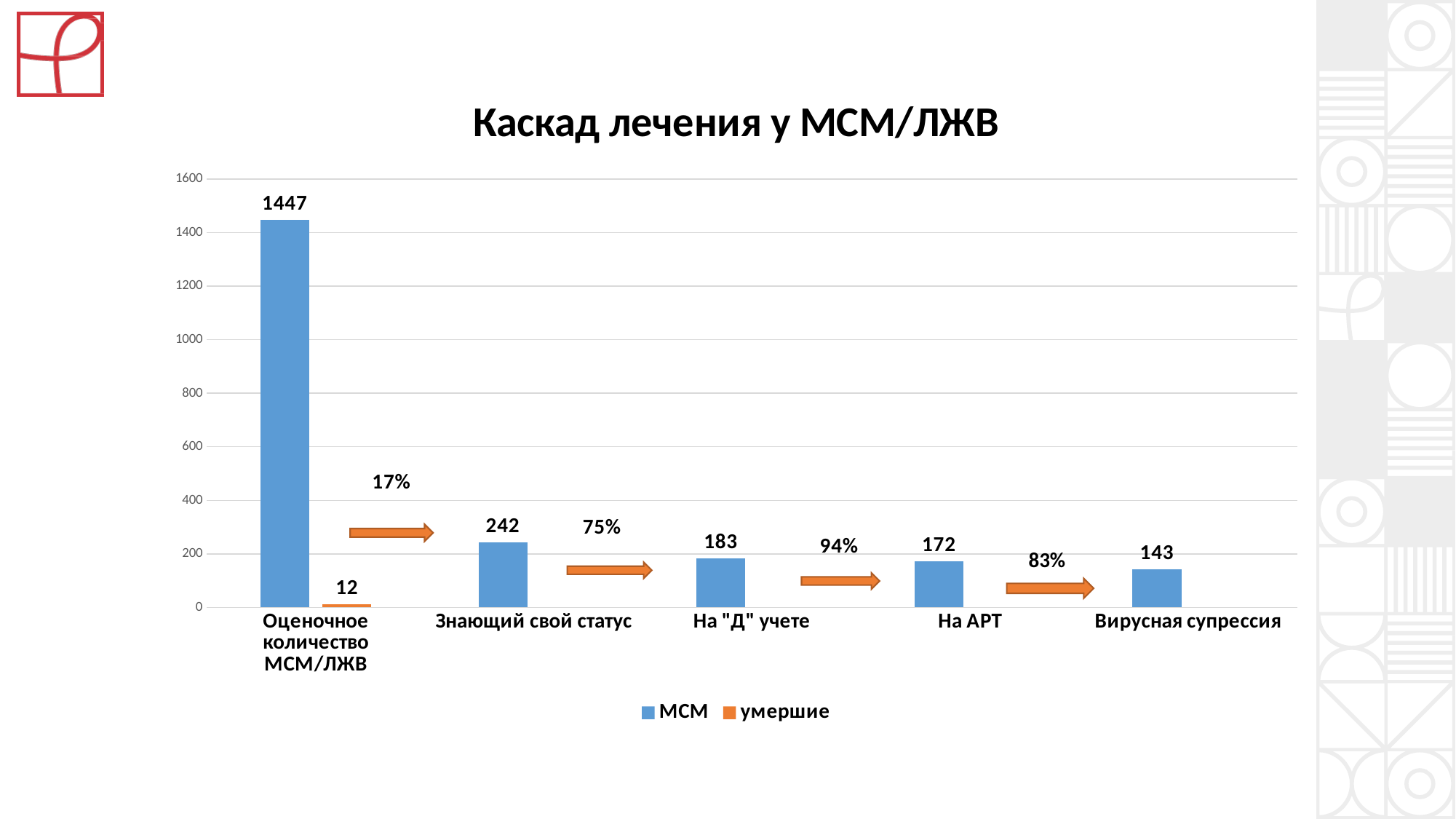
What is the difference between the МСМ values for "Знающий свой статус" and "На "Д" учете"? 59 Which is larger: the МСМ value for "На АРТ" or for "Вирусная супрессия"? На АРТ Which category has the lowest МСМ value? Вирусная супрессия What is the value of the МСМ series for "На АРТ"? 172 How many categories are shown on the x axis? 5 What is the value of the МСМ series for "Оценочное количество МСМ/ЛЖВ"? 1447 Do the МСМ values rise or fall from left to right along the x axis? Fall What kind of chart is shown on the slide? Bar chart How many series does the legend list? 2 What is the value of the МСМ series for "Вирусная супрессия"? 143 Which category has the highest МСМ value? Оценочное количество МСМ/ЛЖВ What is the value of the умершие series for "Оценочное количество МСМ/ЛЖВ"? 12